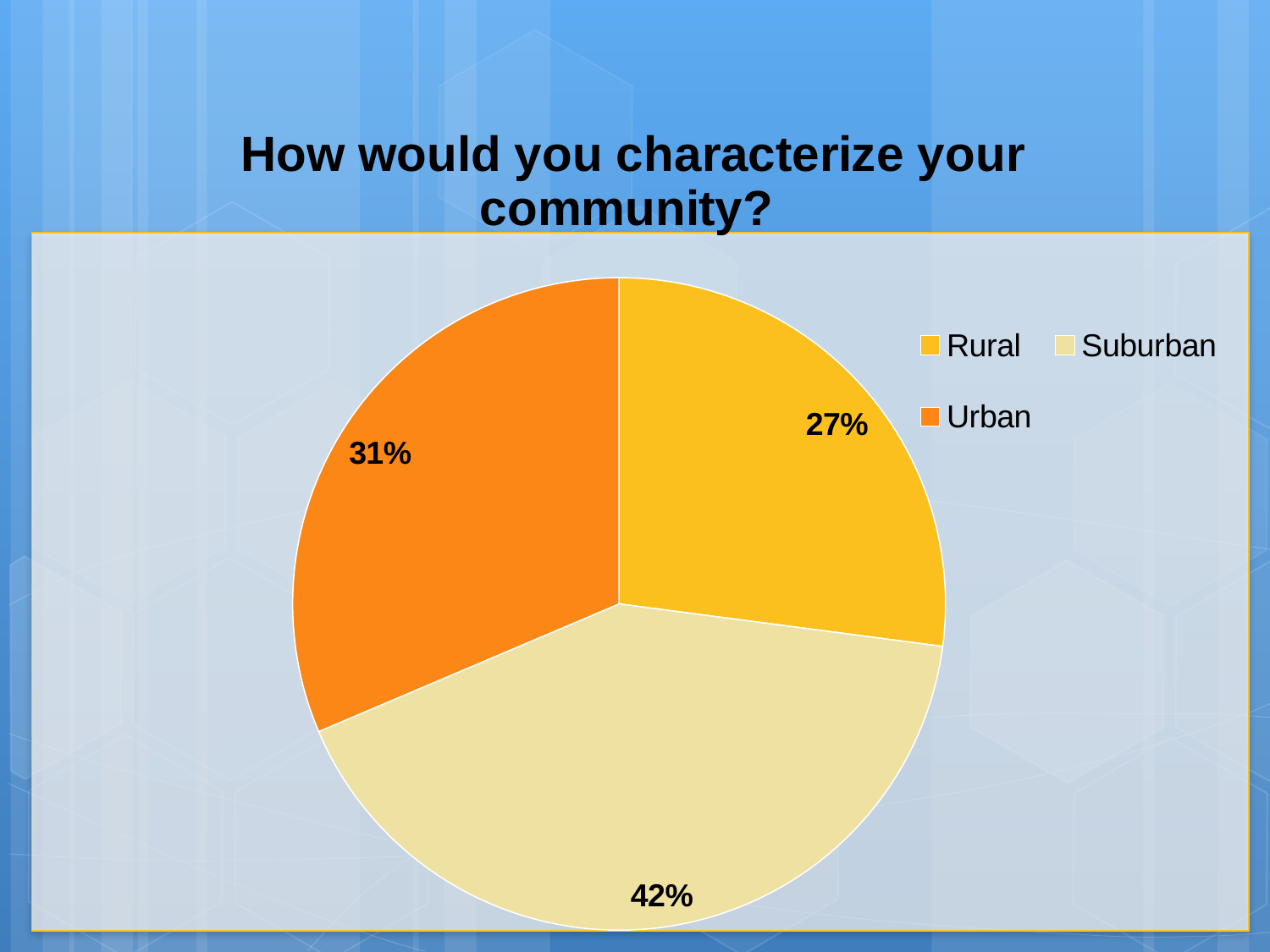
What is the difference in percentage points between the Suburban and Rural shares? 15 Which is larger, the Urban share or the Rural share? Urban What is the difference in percentage points between the Urban and Rural shares? 4 What percentage of respondents characterized their community as Rural? 27% What percentage of respondents characterized their community as Urban? 31% Which community type has the largest share of the pie? Suburban How many slices does the pie chart have? 3 How many entries does the legend list? 3 What kind of chart is shown on the slide? Pie chart What percentage of respondents characterized their community as Suburban? 42% Which community type has the smallest share of the pie? Rural What is the title of the chart? How would you characterize your community?